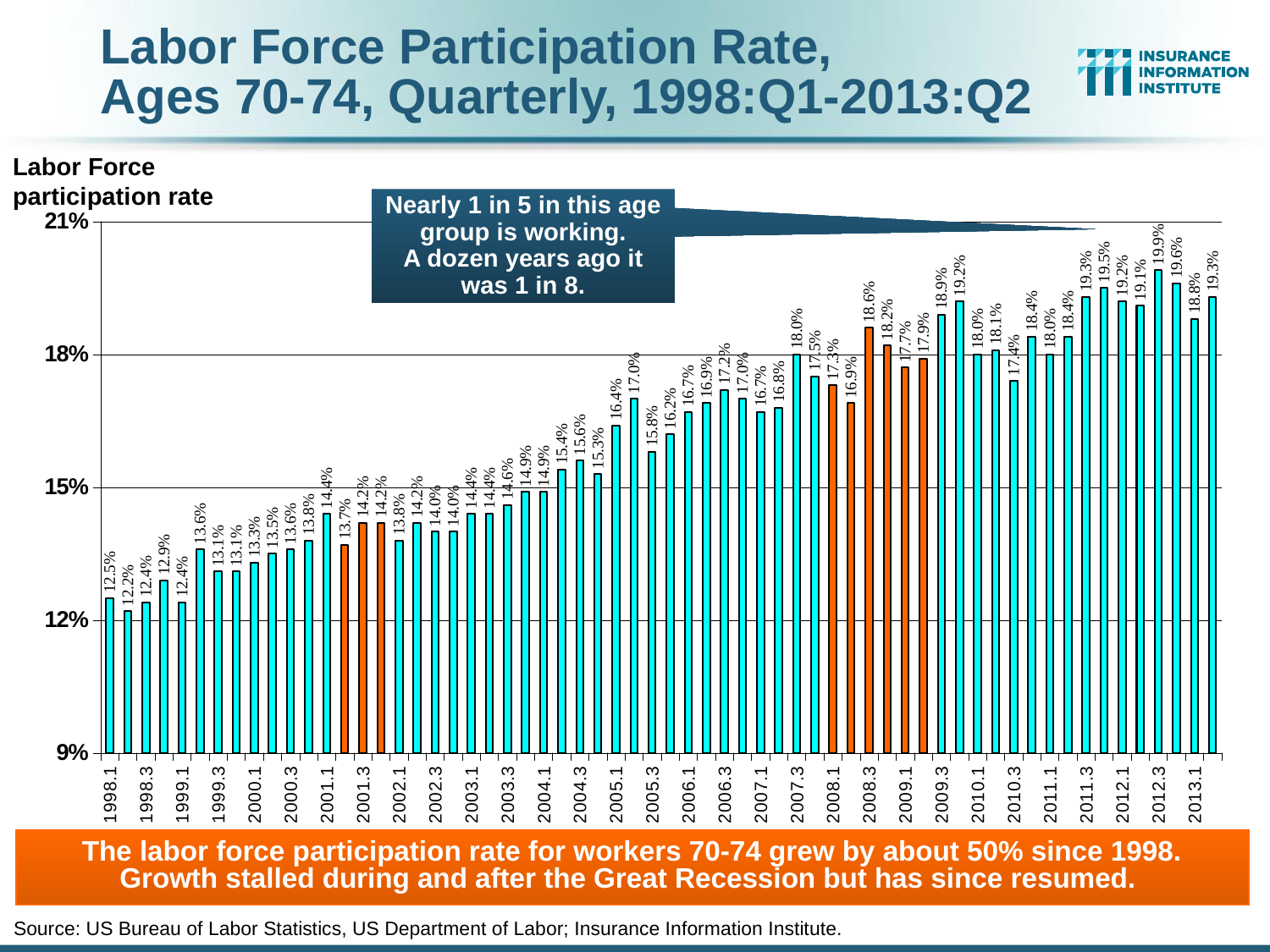
What is the labor force participation rate for 1998.1? 12.5% Which quarter has the highest labor force participation rate? 2012.3 Is the value for 2005.1 greater or less than 15%? greater By how many percentage points does the rate for 2012.3 exceed the rate for 1998.1? 7.4 percentage points What is the lowest labor force participation rate shown on the chart? 12.2% What is the labor force participation rate for 2013.1? 18.8% Do the labor force participation rates generally rise or fall from 1998 to 2013? Rise What is the labor force participation rate for 2012.3? 19.9% What kind of chart is shown on the slide? Bar chart What is the labor force participation rate for 2007.3? 18.0% What is the highest value shown on the vertical axis? 21% Which is larger, the rate for 2009.3 or the rate for 2010.3? 2009.3